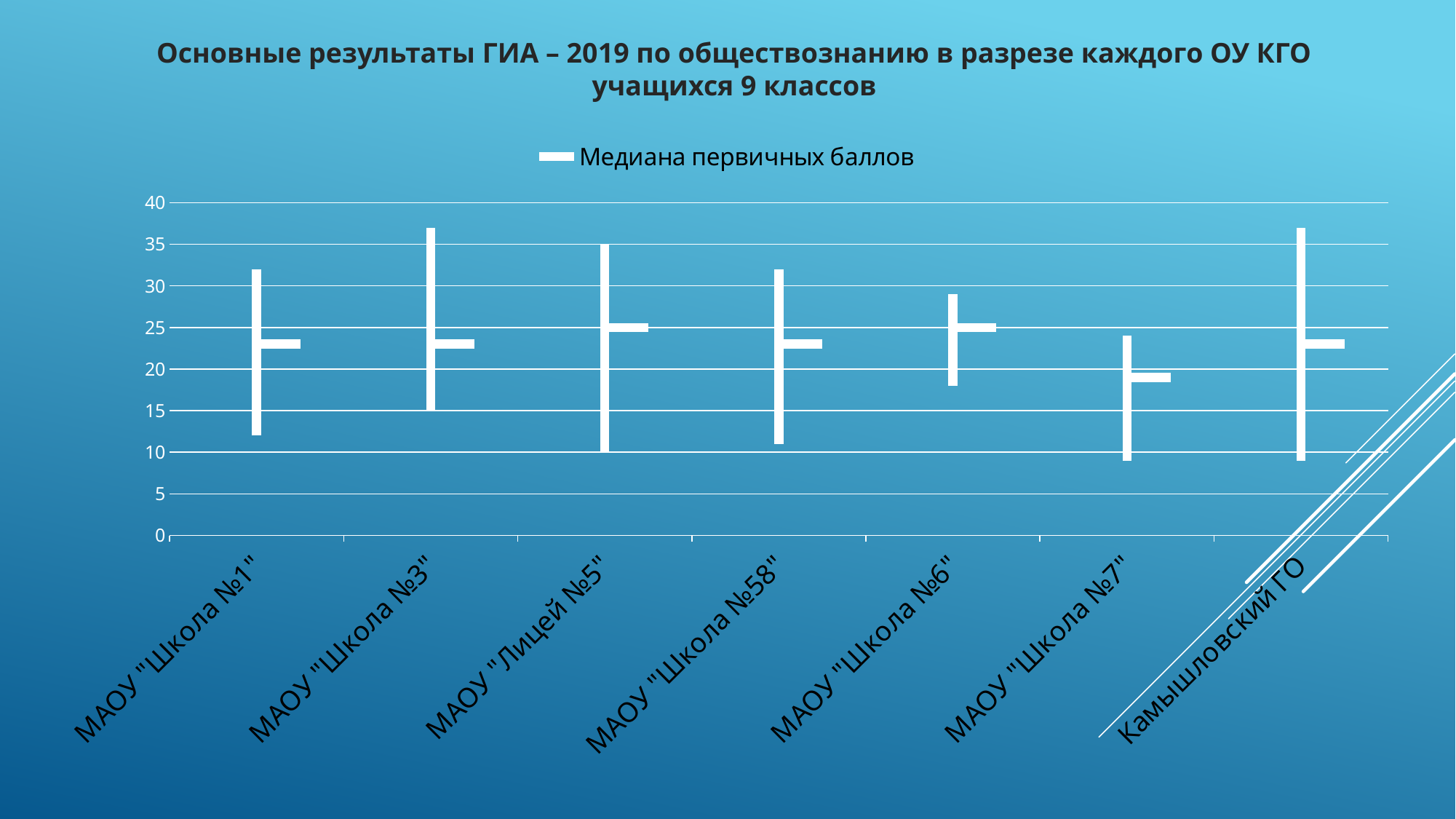
What is the maximum value shown on the chart's vertical axis? 40 Is the median marker for МАОУ "Школа №1" greater or less than 20? greater Which category has the lowest median marker on the chart? МАОУ "Школа №7" Is the top of the range line for МАОУ "Школа №7" greater or less than 25? less Is the bottom of the range line for МАОУ "Школа №6" greater or less than 15? greater Which has the higher median marker: МАОУ "Школа №6" or МАОУ "Школа №7"? МАОУ "Школа №6" What is the name of the series shown in the chart legend? Медиана первичных баллов How many series does the chart legend list? 1 How many categories (educational organisations) are shown on the x axis of the chart? 7